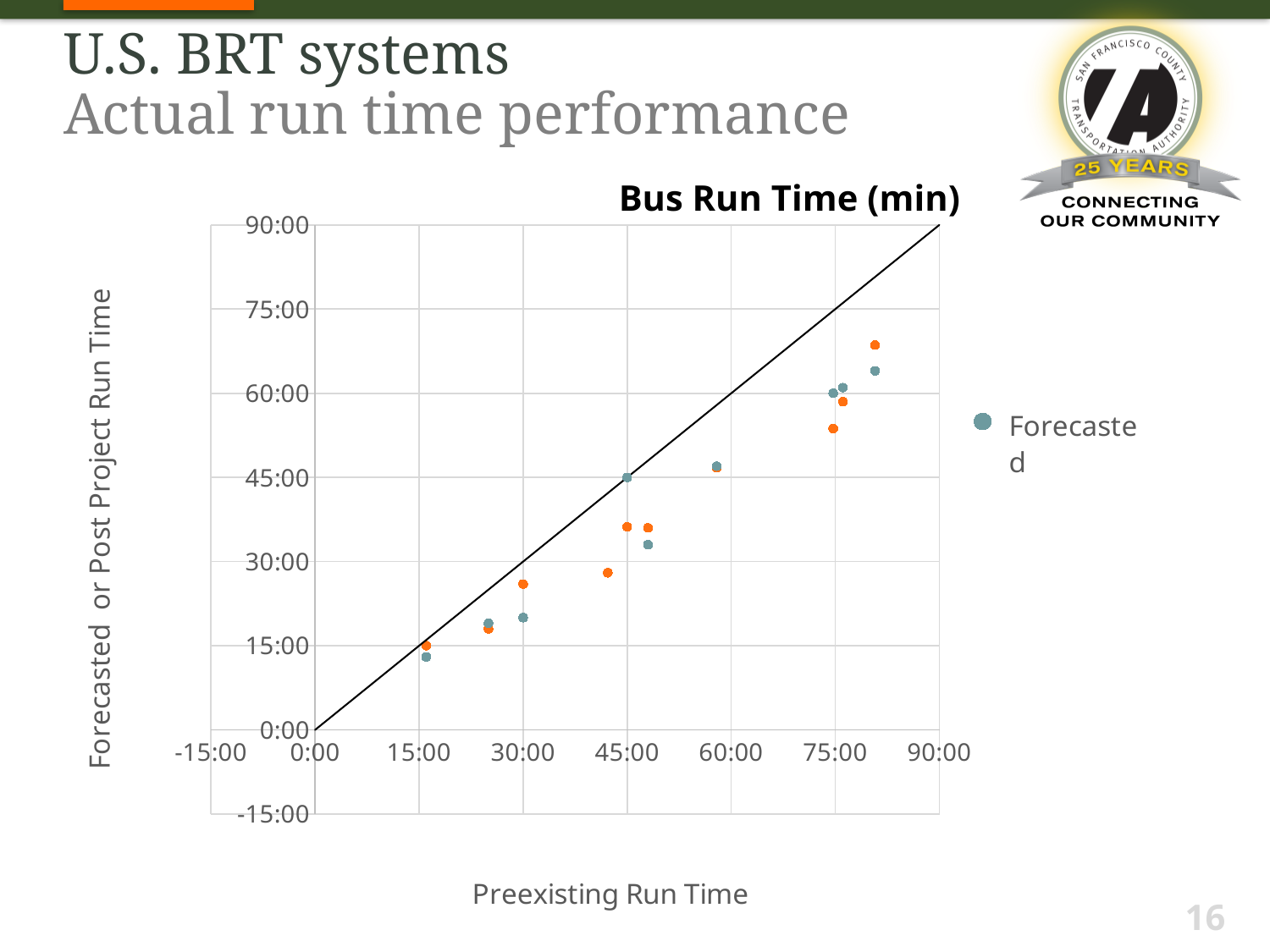
What kind of chart is shown on the slide? Scatter chart How many entries does the chart's legend list? 1 Is the value of the blue point plotted at about 80:00 on the horizontal axis greater or less than 60:00? greater Is the value of the blue point plotted at about 30:00 on the horizontal axis greater or less than 30:00? less Is the value of the orange point plotted at about 80:00 on the horizontal axis greater or less than 60:00? greater At about 30:00 on the horizontal axis, which point is higher, the orange one or the blue one? The orange one What is the title of the chart? Bus Run Time (min) What is the label of the horizontal axis of the chart? Preexisting Run Time Do the plotted values generally rise or fall as the preexisting run time increases along the horizontal axis? Rise At about 80:00 on the horizontal axis, which point is higher, the orange one or the blue one? The orange one